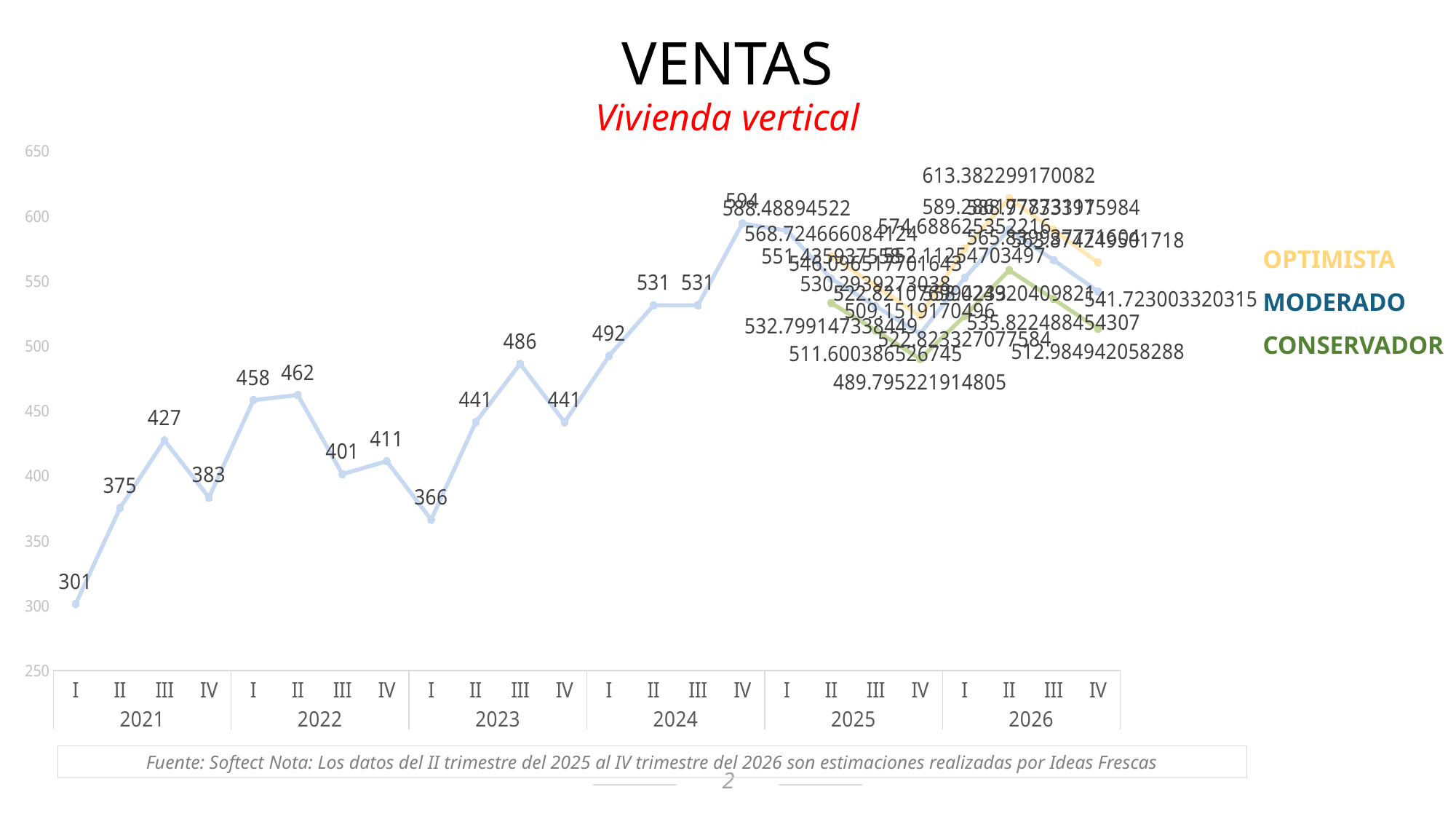
Which quarter of 2021 has the lowest value? I (301) Which quarter of 2022 has the highest value? II (462) Which is larger, the value for quarter III of 2023 or the value for quarter III of 2022? Quarter III of 2023 (486) How many years are shown on the x axis? 6 What is the value for quarter I of 2021? 301 What is the difference between the values for quarter II of 2021 (375) and quarter I of 2021 (301)? 74 Is the value for quarter II of 2024 greater or less than 500? greater What is the value for quarter IV of 2024? 594 What are the three scenario labels shown to the right of the chart? OPTIMISTA, MODERADO, CONSERVADOR What kind of chart is shown on the slide? Line chart What is the value for quarter I of 2023? 366 What is the value for quarter III of 2021? 427